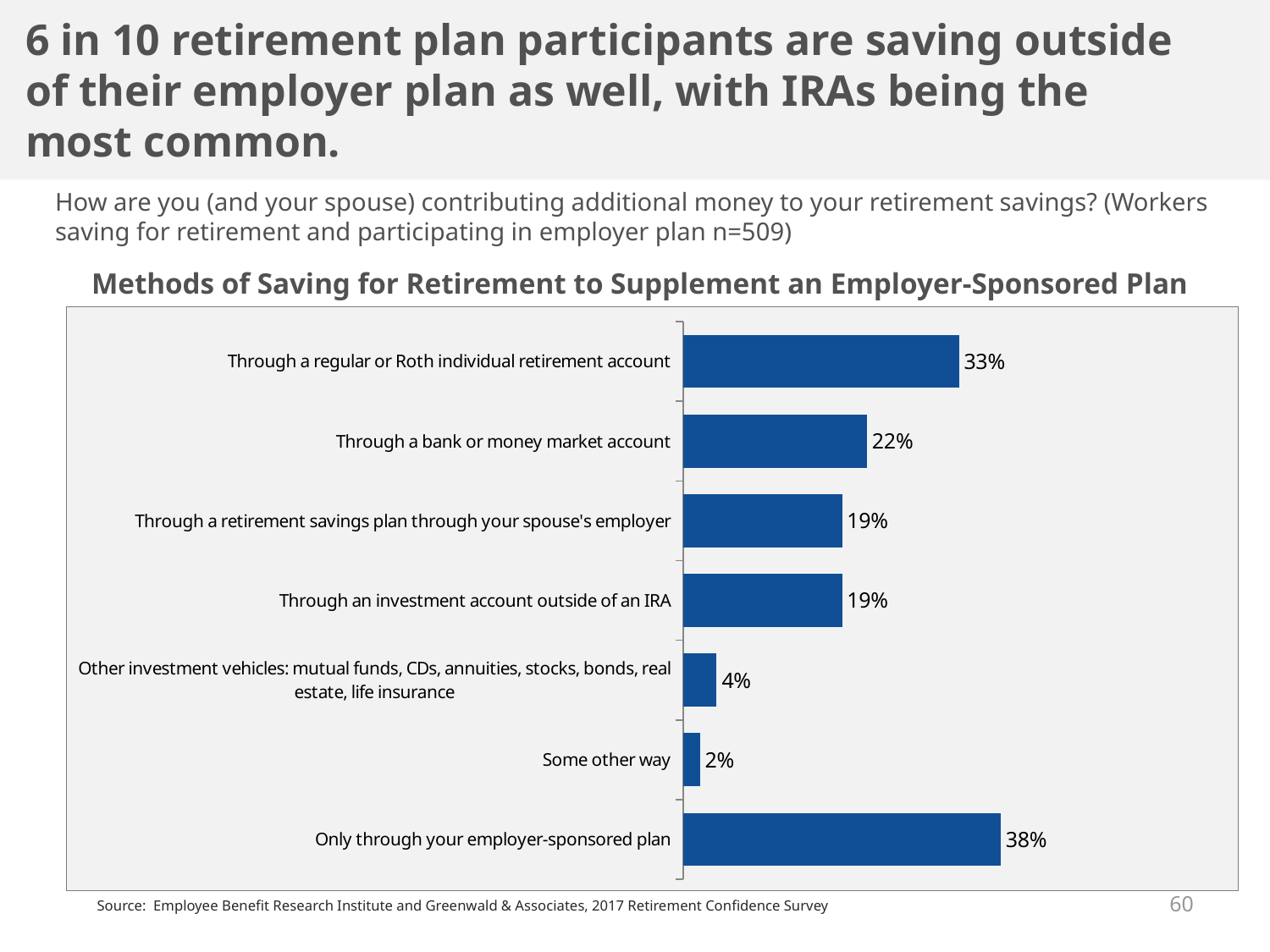
What percentage of respondents save through a regular or Roth individual retirement account? 33% What is the title of the chart? Methods of Saving for Retirement to Supplement an Employer-Sponsored Plan What is the value for 'Other investment vehicles: mutual funds, CDs, annuities, stocks, bonds, real estate, life insurance'? 4% Which is larger: the value for 'Through a bank or money market account' or 'Through an investment account outside of an IRA'? Through a bank or money market account What is the value for 'Through a bank or money market account'? 22% How many categories are shown in the chart? 7 What percentage save only through their employer-sponsored plan? 38% What is the value for 'Some other way'? 2% What is the difference between the value for 'Through a regular or Roth individual retirement account' and 'Through a bank or money market account'? 11% Which category has the lowest value in the chart? Some other way What kind of chart is shown on the slide? Bar chart Which category has the highest value in the chart? Only through your employer-sponsored plan